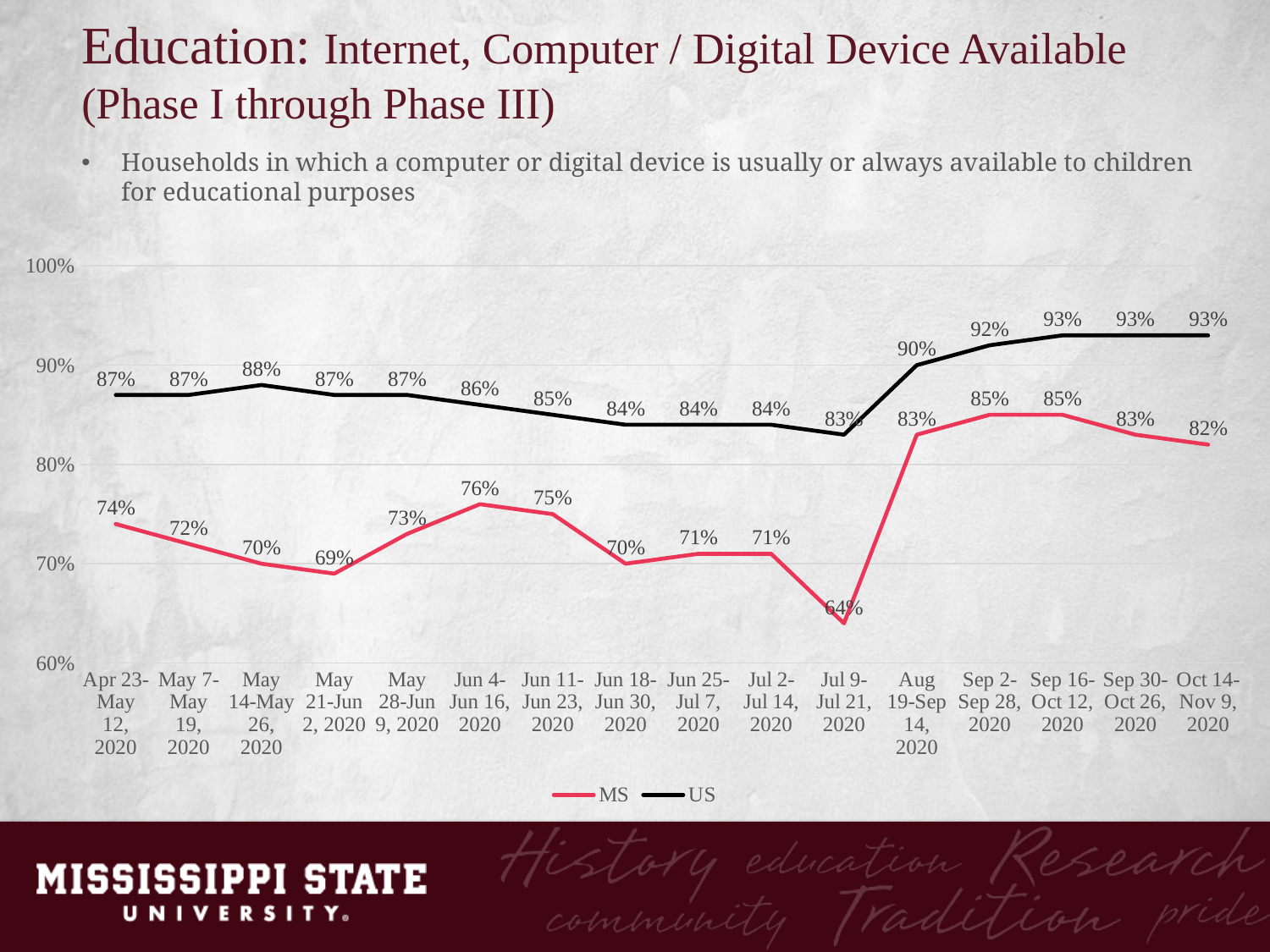
How many series does the legend list? 2 What is the difference between the US and MS values for the Sep 16-Oct 12, 2020 period? 8% What is the MS value for the Apr 23-May 12, 2020 period? 74% What is the US value for the Oct 14-Nov 9, 2020 period? 93% What is the MS value for the Jul 9-Jul 21, 2020 period? 64% What is the difference between the US and MS values for the Jul 9-Jul 21, 2020 period? 19% Which is larger, the MS value for Jun 4-Jun 16, 2020 or the MS value for Jul 2-Jul 14, 2020? Jun 4-Jun 16, 2020 How many time periods are plotted on the x axis? 16 Which period has the highest US value among the first eleven periods (Apr 23 through Jul 21)? May 14-May 26, 2020 What type of chart is shown on the slide? Line chart Which series is drawn in red? MS Which period has the lowest MS value? Jul 9-Jul 21, 2020